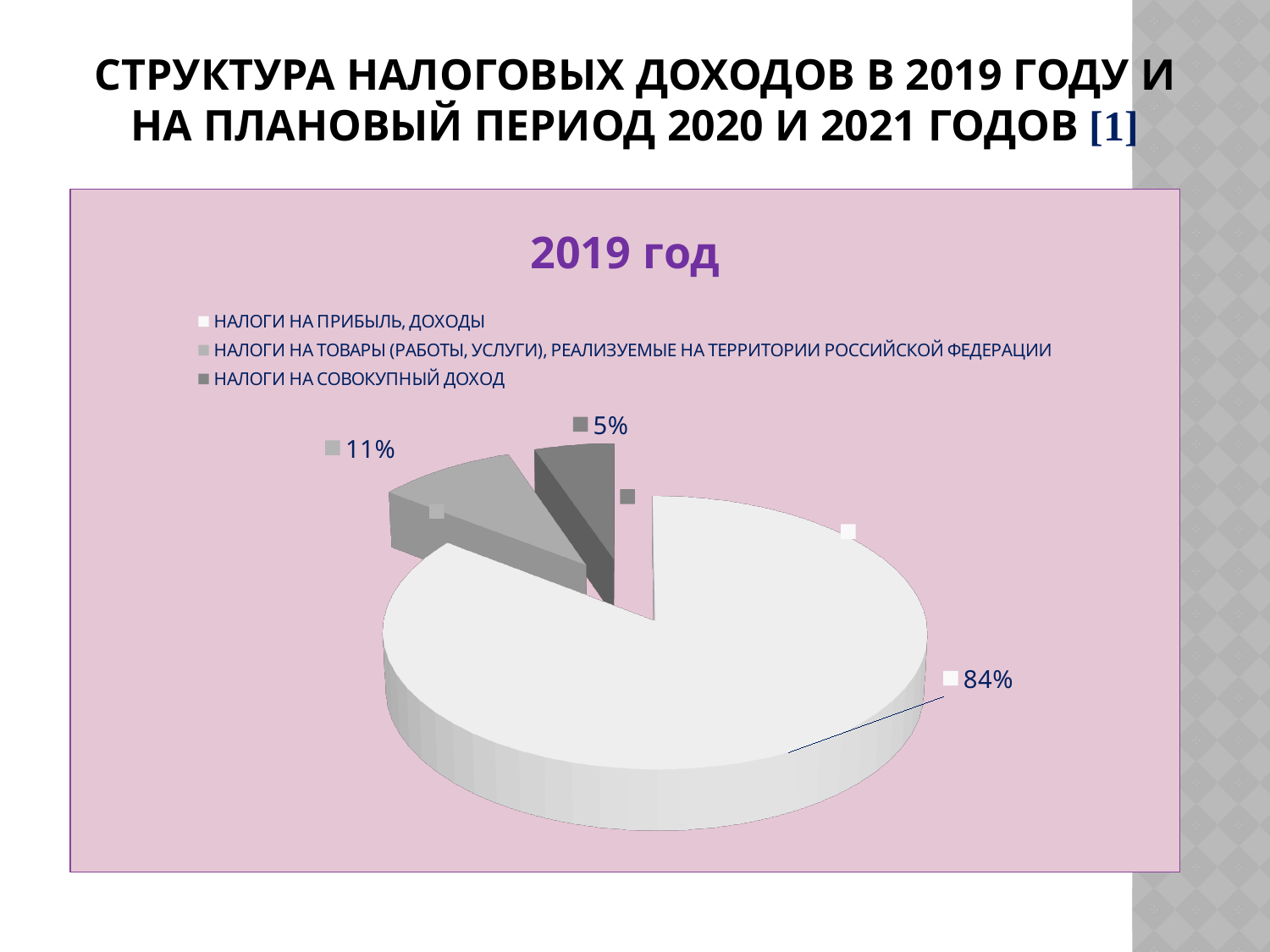
Which category has the smallest share of the pie? НАЛОГИ НА СОВОКУПНЫЙ ДОХОД What share of the pie is НАЛОГИ НА ТОВАРЫ (РАБОТЫ, УСЛУГИ), РЕАЛИЗУЕМЫЕ НА ТЕРРИТОРИИ РОССИЙСКОЙ ФЕДЕРАЦИИ? 11% What colour is the slice for НАЛОГИ НА ПРИБЫЛЬ, ДОХОДЫ? White What share of the pie is НАЛОГИ НА ПРИБЫЛЬ, ДОХОДЫ? 84% What is the title of the chart? 2019 год What kind of chart is shown on the slide? Pie chart Which category has the largest share of the pie? НАЛОГИ НА ПРИБЫЛЬ, ДОХОДЫ How many slices does the pie chart have? 3 What share of the pie is НАЛОГИ НА СОВОКУПНЫЙ ДОХОД? 5% What is the difference in percentage points between the share of НАЛОГИ НА ПРИБЫЛЬ, ДОХОДЫ and the share of НАЛОГИ НА ТОВАРЫ (РАБОТЫ, УСЛУГИ), РЕАЛИЗУЕМЫЕ НА ТЕРРИТОРИИ РОССИЙСКОЙ ФЕДЕРАЦИИ? 73 percentage points Which is larger: the share of НАЛОГИ НА ТОВАРЫ (РАБОТЫ, УСЛУГИ), РЕАЛИЗУЕМЫЕ НА ТЕРРИТОРИИ РОССИЙСКОЙ ФЕДЕРАЦИИ or the share of НАЛОГИ НА СОВОКУПНЫЙ ДОХОД? НАЛОГИ НА ТОВАРЫ (РАБОТЫ, УСЛУГИ), РЕАЛИЗУЕМЫЕ НА ТЕРРИТОРИИ РОССИЙСКОЙ ФЕДЕРАЦИИ How many entries does the legend list? 3